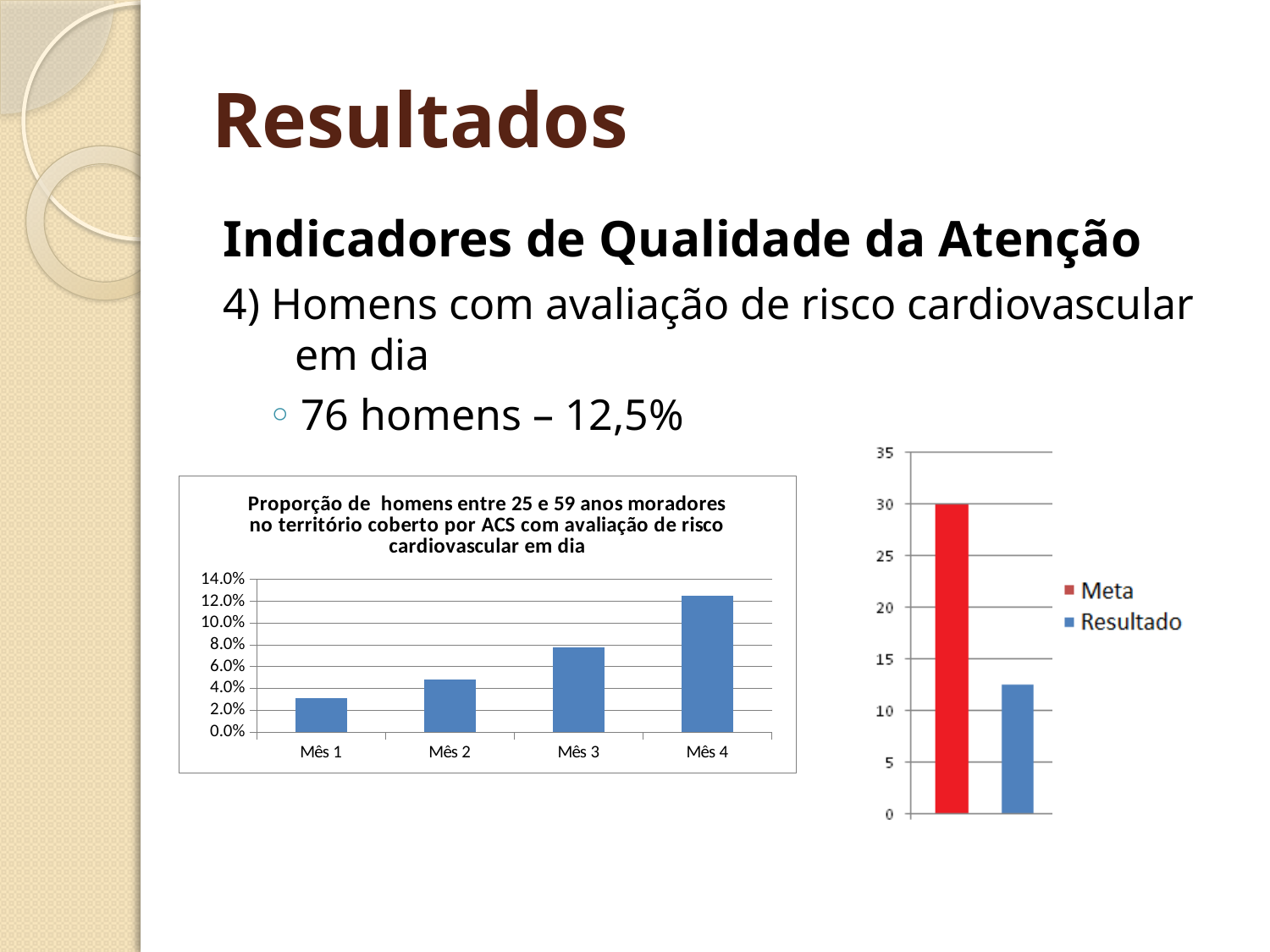
In the left chart, is the value for Mês 1 greater or less than 4.0%? less In the right chart, what is the value of Meta? 30 How many series does the legend of the right chart list? 2 In the left chart, which month has the highest bar? Mês 4 In the left chart, which month has the lowest bar? Mês 1 What kind of chart is the left chart? bar chart In the left chart, do the values rise or fall from Mês 1 to Mês 4? rise In the left chart, is the value for Mês 3 greater or less than 6.0%? greater In the right chart, is the value for Resultado greater or less than 10? greater In the left chart, which is larger, the value for Mês 2 or the value for Mês 3? Mês 3 In the left chart, how many months are shown on the x axis? 4